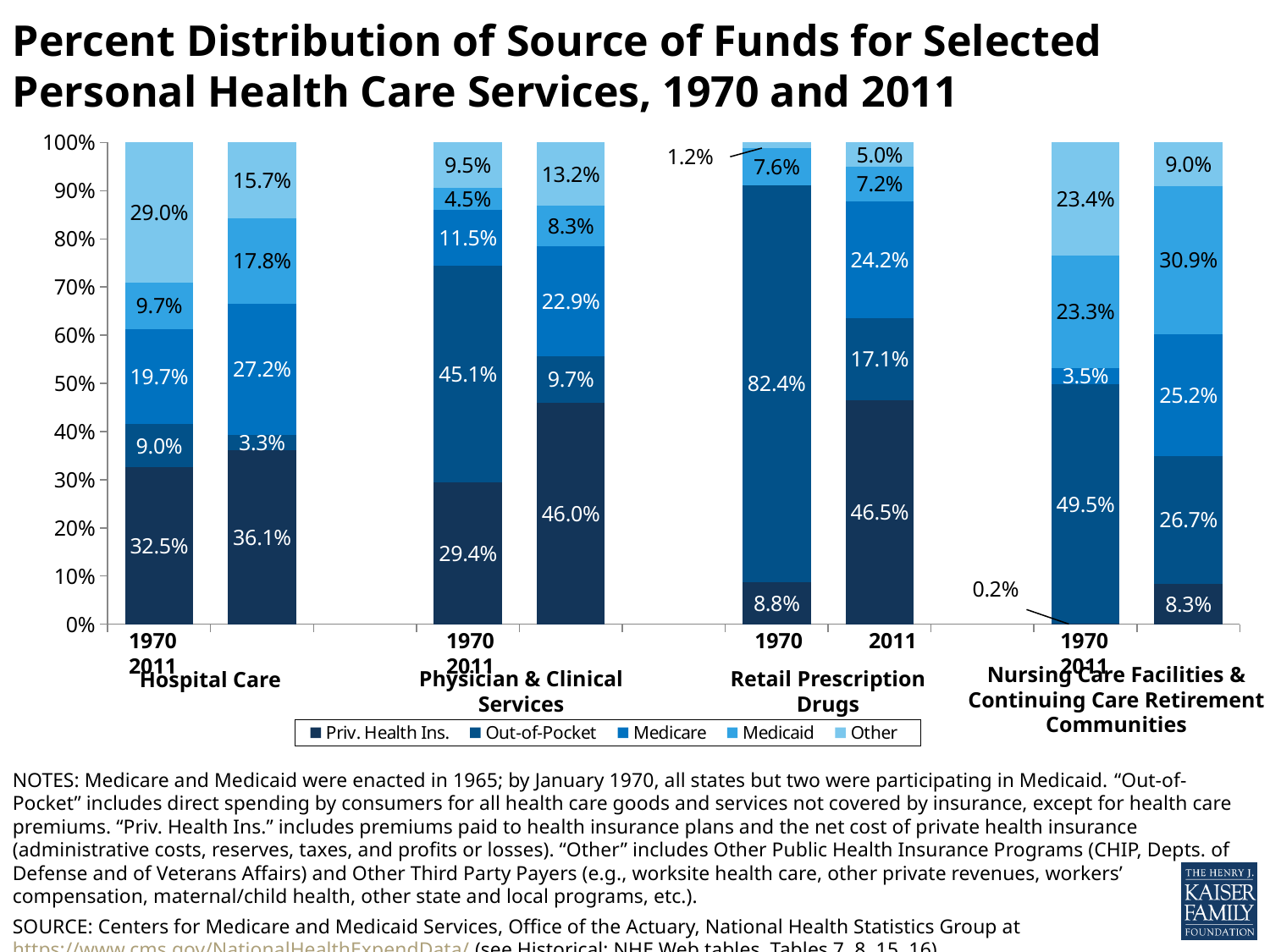
What is the difference between the Priv. Health Ins. share of Hospital Care funds in 2011 and in 1970? 3.6 percentage points What percent of Nursing Care Facilities & Continuing Care Retirement Communities funds came from Medicaid in 2011? 30.9% Which series is shown in the darkest blue at the bottom of each bar? Priv. Health Ins. What type of chart is shown on the slide? Stacked bar chart By how many percentage points did the Out-of-Pocket share of Retail Prescription Drugs funds change from 1970 (82.4%) to 2011 (17.1%)? 65.3 percentage points Which was larger for Physician & Clinical Services in 2011: the Priv. Health Ins. share or the Medicare share? Priv. Health Ins. What percent of Hospital Care funds came from Priv. Health Ins. in 1970? 32.5% How many series does the legend list? 5 What percent of Retail Prescription Drugs funds came from Out-of-Pocket in 1970? 82.4% What percent of Hospital Care funds came from Medicare in 2011? 27.2% What percent of Physician & Clinical Services funds came from Out-of-Pocket in 1970? 45.1% How many health care service categories are shown along the x axis? 4